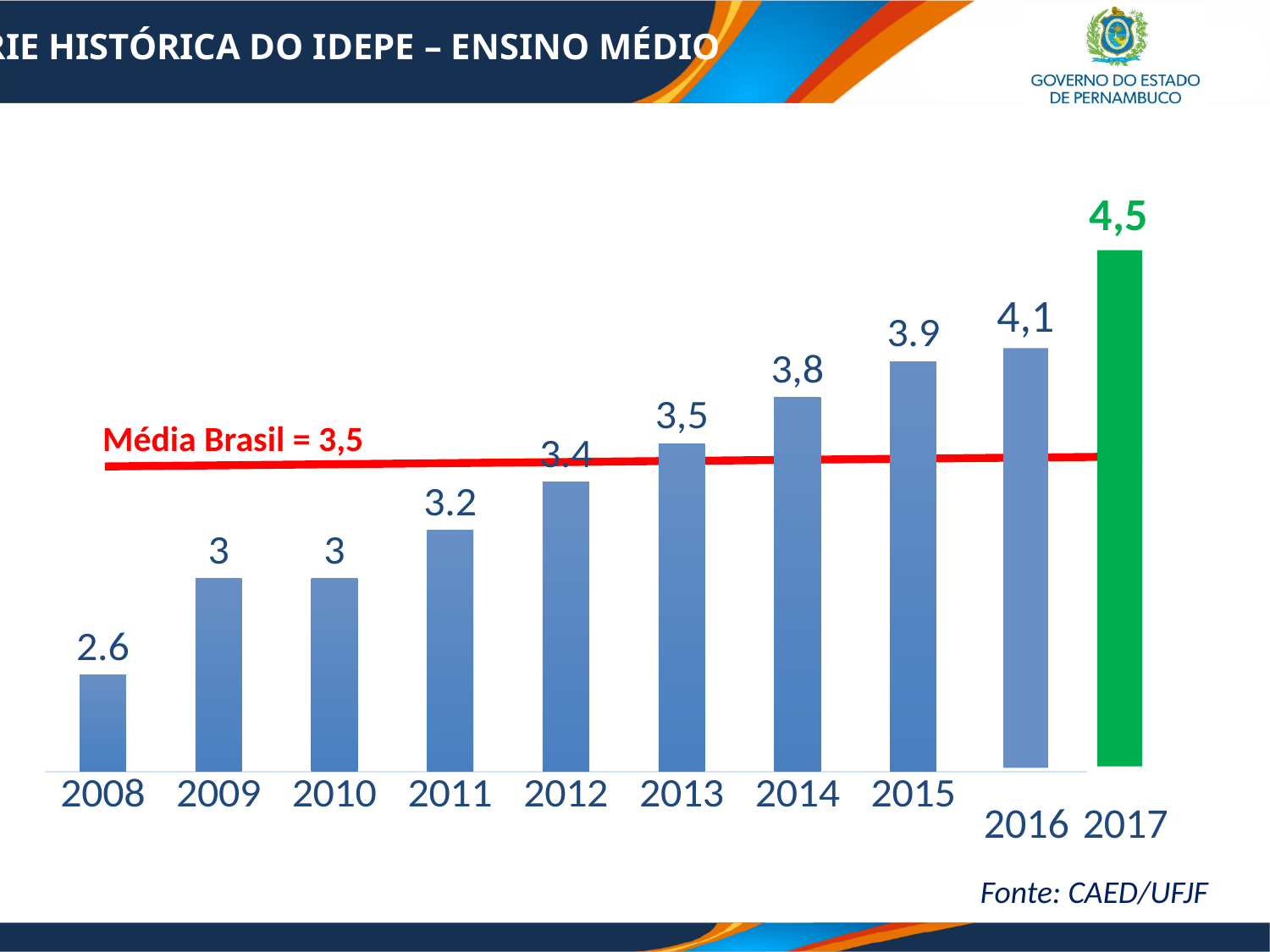
What is the difference between the values for 2017 and 2016? 0,4 Which year has the lowest value? 2008 What is the value for 2013? 3,5 What is the value for 2017? 4,5 How many years are shown on the x axis? 10 Do the values rise or fall from 2008 to 2017? Rise Which year has the highest value? 2017 What kind of chart is shown on the slide? Bar chart What is the difference between the values for 2011 and 2008? 0.6 What is the value for 2008? 2.6 What is the value for 2014? 3,8 Which is larger, the value for 2014 or the value for 2012? 2014